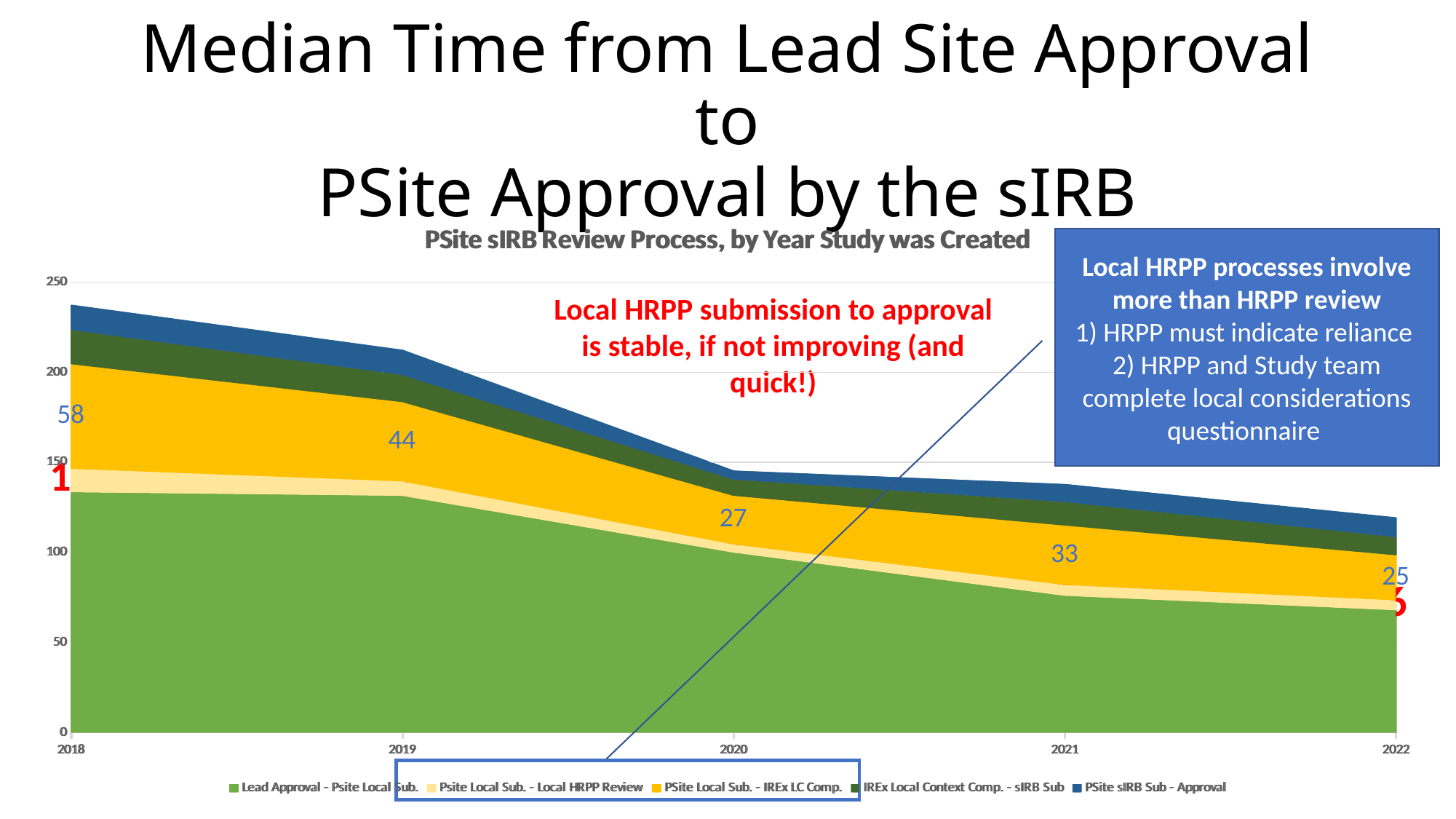
Does the total stacked value rise or fall from 2018 to 2022? Fall What value is labelled in the yellow (PSite Local Sub. - IREx LC Comp.) area for 2019? 44 Is the total stacked value for 2018 greater or less than 200? greater How many series does the chart legend list? 5 In which year is the labelled value in the yellow area the lowest? 2022 What is the difference between the labelled yellow-area values for 2018 and 2019? 14 How many years are shown along the x axis of the chart? 5 What value is labelled in the yellow (PSite Local Sub. - IREx LC Comp.) area for 2022? 25 What value is labelled in the yellow (PSite Local Sub. - IREx LC Comp.) area for 2020? 27 What kind of chart is shown on the slide? Stacked area chart In which year is the labelled value in the yellow area the highest? 2018 Which year has the larger labelled yellow-area value, 2020 or 2021? 2021